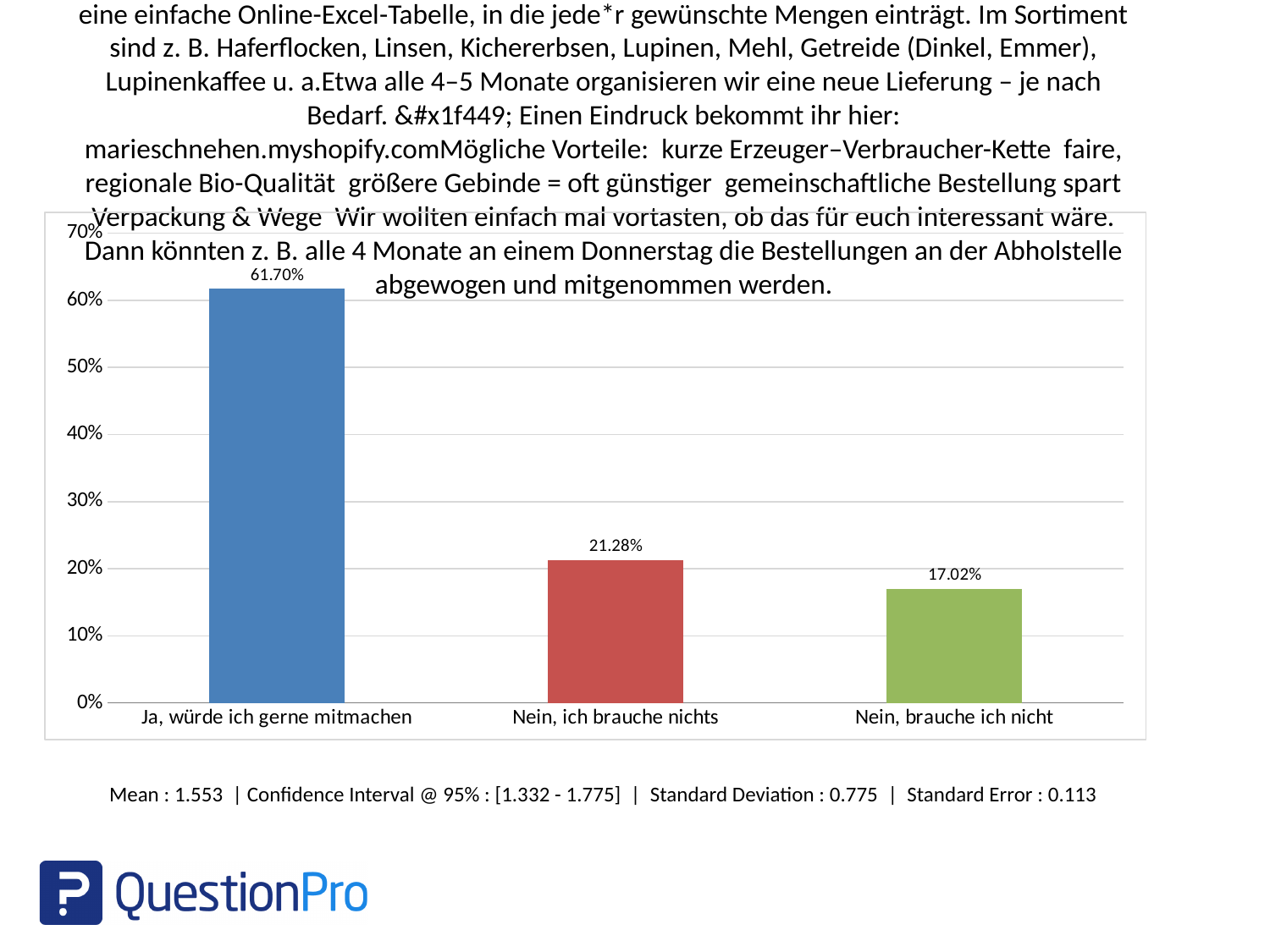
How many categories are shown in the chart? 3 What is the difference between the values for "Ja, würde ich gerne mitmachen" and "Nein, ich brauche nichts"? 40.42% What colour is the bar for "Nein, ich brauche nichts"? red What is the value for "Nein, brauche ich nicht"? 17.02% What is the value for "Ja, würde ich gerne mitmachen"? 61.70% Is the value for "Ja, würde ich gerne mitmachen" greater or less than 50%? greater What is the value for "Nein, ich brauche nichts"? 21.28% Which category has the lowest value? Nein, brauche ich nicht What kind of chart is shown on the slide? bar chart What is the difference between the values for "Nein, ich brauche nichts" and "Nein, brauche ich nicht"? 4.26% Which category has the highest value? Ja, würde ich gerne mitmachen Which is larger, the value for "Nein, ich brauche nichts" or "Nein, brauche ich nicht"? Nein, ich brauche nichts